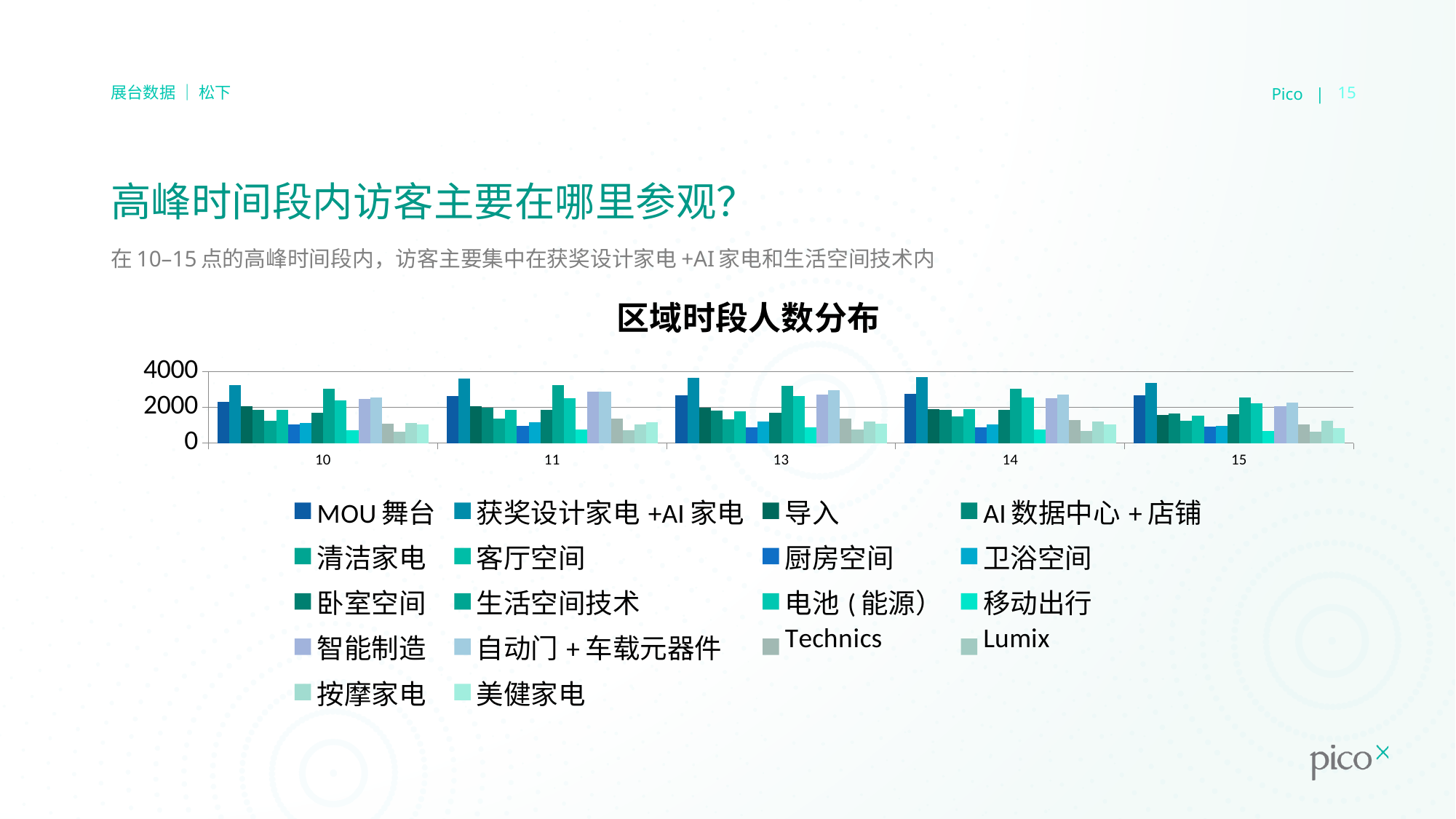
Is the value for Technics at time slot 10 greater or less than 2000? less Is the value for 智能制造 at time slot 11 greater or less than 2000? greater Is the value for 电池 ( 能源） at time slot 11 greater or less than 2000? greater How many time-slot categories are shown on the x axis of the chart? 5 What is the title of the chart? 区域时段人数分布 Which series has the highest value at time slot 14? 获奖设计家电 +AI 家电 What kind of chart is shown on the slide? bar chart Which time slots are labelled on the x axis of the chart? 10, 11, 13, 14, 15 At time slot 13, which is larger: 获奖设计家电 +AI 家电 or 导入? 获奖设计家电 +AI 家电 How many series does the chart's legend list? 18